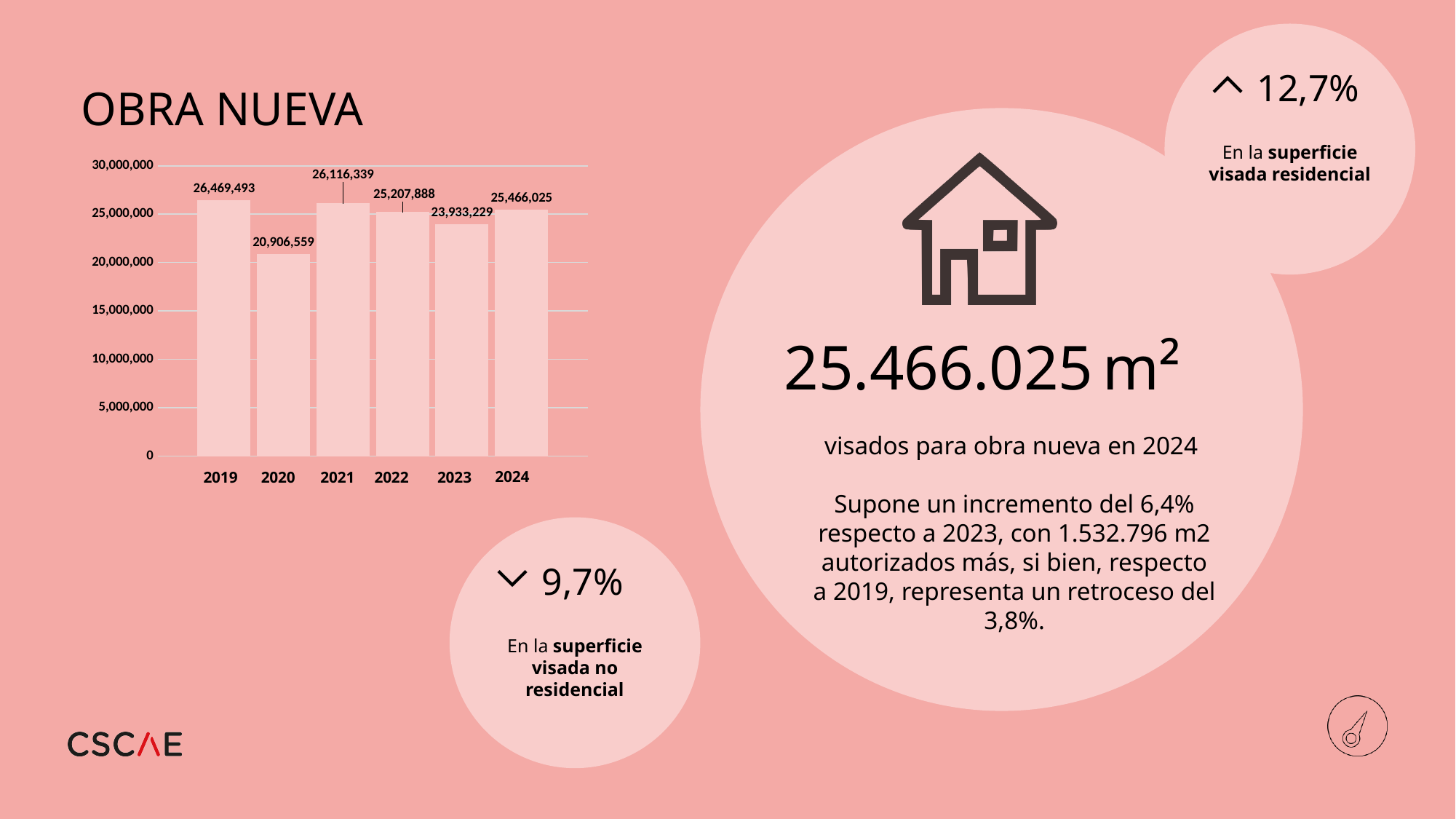
What is the value shown for 2024? 25,466,025 Which year has the highest value in the chart? 2019 What is the value shown for 2019? 26,469,493 Do the values rise or fall from 2019 to 2020? fall What is the value shown for 2020? 20,906,559 What is the difference between the values for 2024 and 2023? 1,532,796 Which year has the lowest value in the chart? 2020 Is the value for 2020 greater or less than 25,000,000? less Which is larger, the value for 2022 or the value for 2023? 2022 What kind of chart is shown on the slide? bar chart What is the difference between the values for 2019 and 2020? 5,562,934 How many years are shown on the x axis of the chart? 6